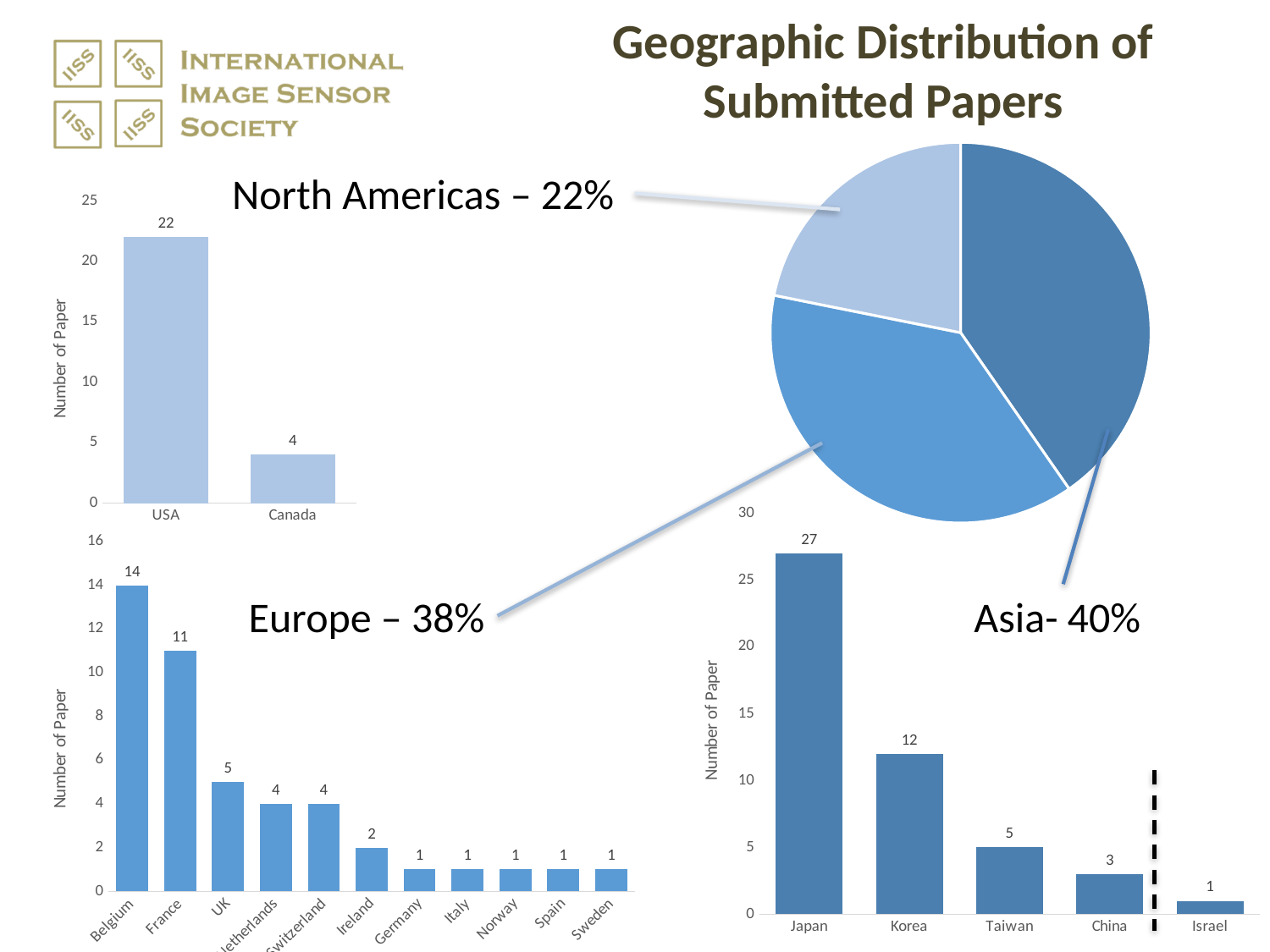
In the North America bar chart (top left), how many papers were submitted from the USA? 22 In the Asia bar chart (bottom right), how many papers were submitted from Japan? 27 In the Europe bar chart (bottom left), how many countries are shown on the x axis? 11 In the Asia bar chart (bottom right), which country has the lowest number of papers? Israel In the Europe bar chart (bottom left), how many papers were submitted from France? 11 In the Asia bar chart (bottom right), do the values rise or fall from left to right along the x axis? fall In the pie chart, what share of submitted papers comes from Asia? 40% In the Europe bar chart (bottom left), which is larger, the value for UK or the value for Ireland? UK In the Asia bar chart (bottom right), what is the difference between the Japan and Korea values? 15 What type of chart is the chart titled 'Geographic Distribution of Submitted Papers'? pie chart In the North America bar chart (top left), what is the difference between the USA and Canada values? 18 In the Europe bar chart (bottom left), which country has the highest number of papers? Belgium